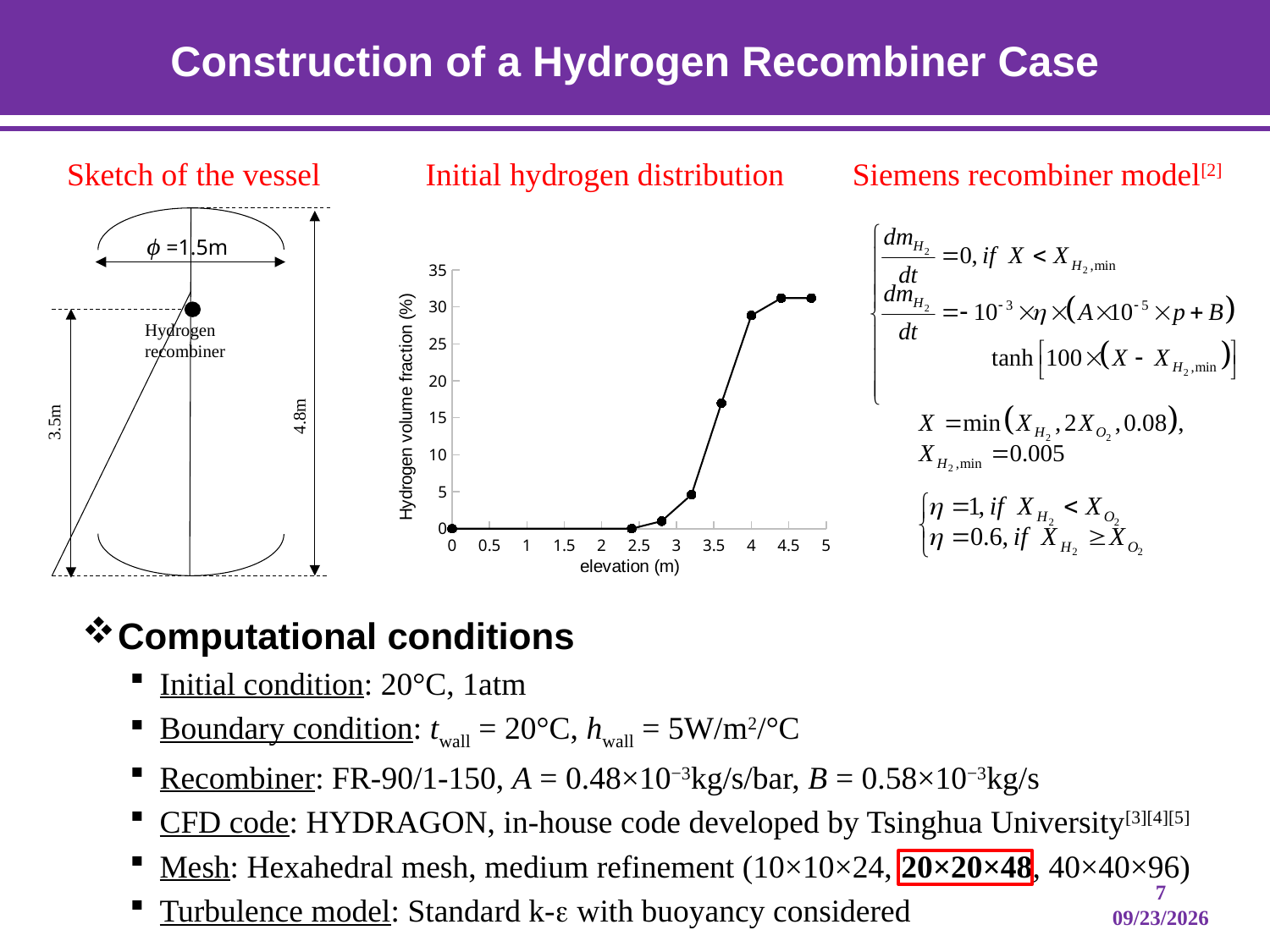
In the initial hydrogen distribution chart, is the hydrogen volume fraction at an elevation of 4.8 m greater or less than 25? greater In the initial hydrogen distribution chart, is the hydrogen volume fraction at an elevation of 2.4 m greater or less than 5? less In the initial hydrogen distribution chart, is the hydrogen volume fraction at an elevation of 3.2 m greater or less than 10? less In the initial hydrogen distribution chart, is the hydrogen volume fraction higher at an elevation of 4.4 m or at 3.2 m? 4.4 m What kind of chart is used to show the initial hydrogen distribution? line chart In the initial hydrogen distribution chart, does the hydrogen volume fraction rise or fall as elevation increases? rise In the initial hydrogen distribution chart, what is the label of the x axis? elevation (m) How many data points are plotted in the initial hydrogen distribution chart? 8 In the initial hydrogen distribution chart, what is the label of the y axis? Hydrogen volume fraction (%)